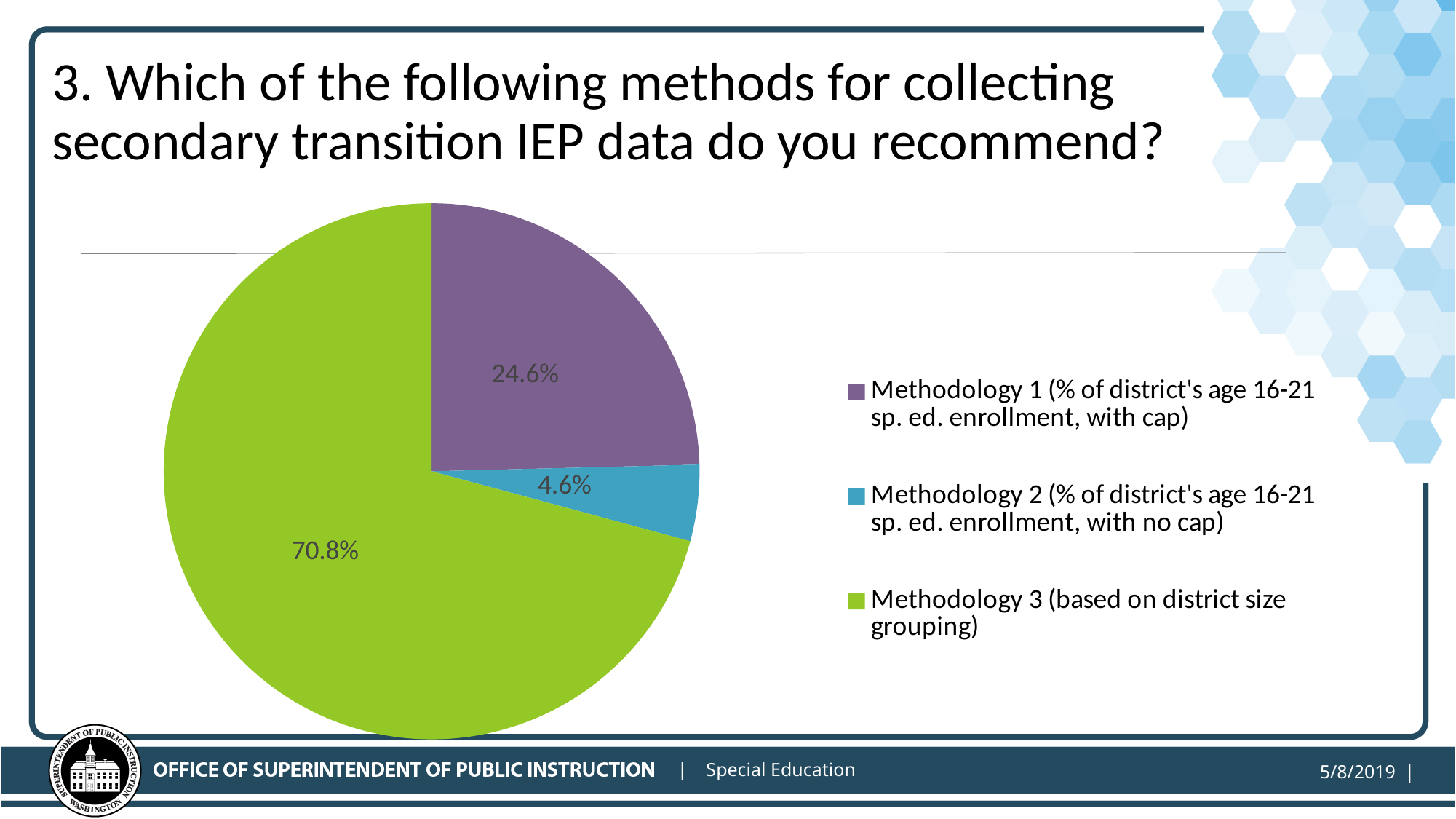
What is the difference in percentage points between the shares for Methodology 1 and Methodology 2? 20 What kind of chart is shown on the slide? Pie chart Which has a larger share, Methodology 1 or Methodology 2? Methodology 1 How many entries does the legend list? 3 Which methodology has the largest share of the pie? Methodology 3 (based on district size grouping) Which methodology has the smallest share of the pie? Methodology 2 (% of district's age 16-21 sp. ed. enrollment, with no cap) What share of the pie does Methodology 2 (% of district's age 16-21 sp. ed. enrollment, with no cap) have? 4.6% How many slices does the pie chart have? 3 What is the difference in percentage points between the shares for Methodology 3 and Methodology 1? 46.2 What share of the pie does Methodology 3 (based on district size grouping) have? 70.8% What share of the pie does Methodology 1 (% of district's age 16-21 sp. ed. enrollment, with cap) have? 24.6% What colour is the slice for Methodology 3 (based on district size grouping)? Green